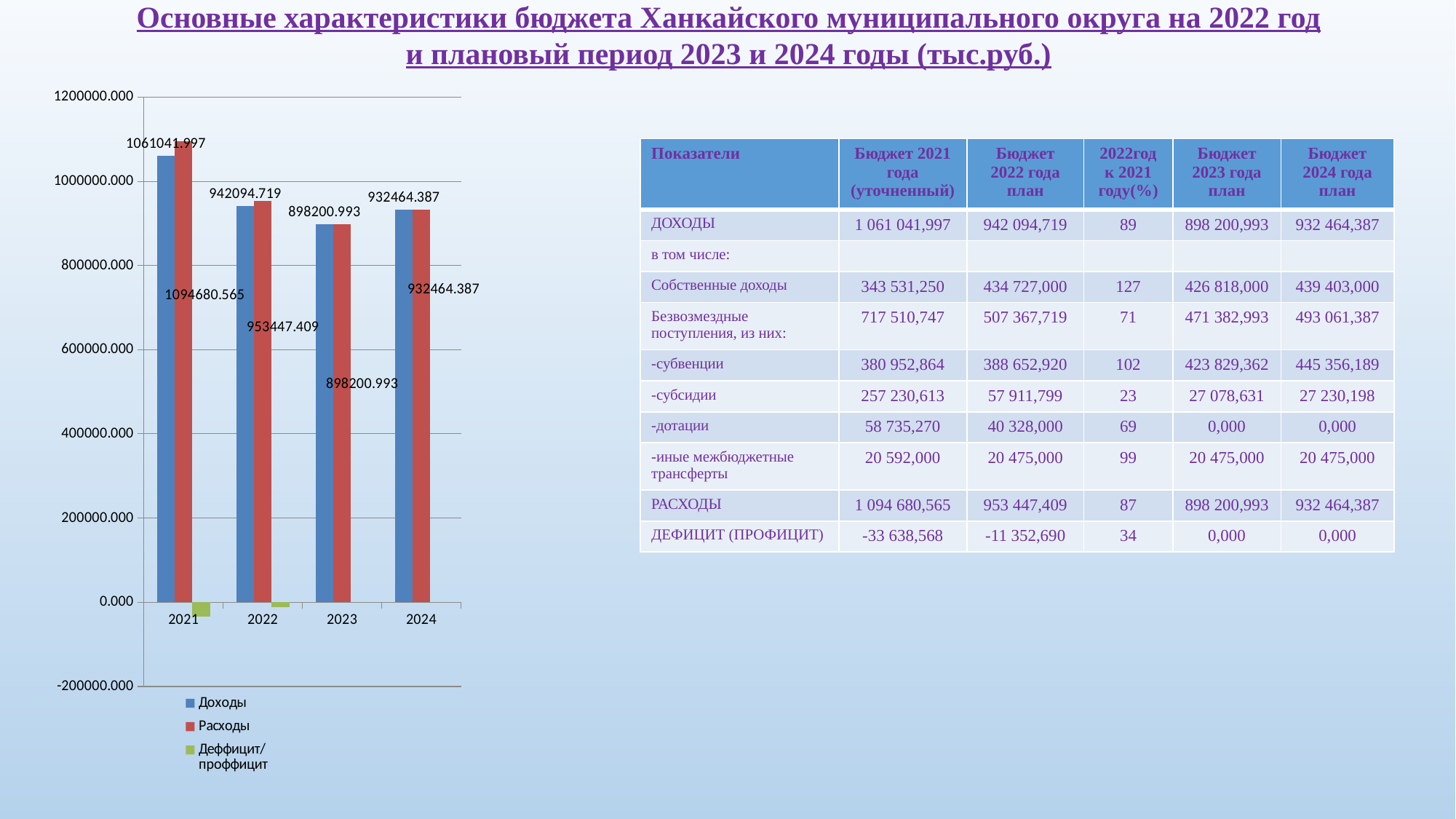
How many years are shown on the x axis of the chart? 4 What is the difference between Расходы and Доходы for 2021 in the chart? 33638.568 What is the value of Расходы for 2024 in the chart? 932464.387 What type of chart is shown on the slide? bar chart What is the value of Расходы for 2022 in the chart? 953447.409 What is the value of Доходы for 2023 in the chart? 898200.993 What is the value of Доходы for 2021 in the chart? 1061041.997 In which year is Доходы highest in the chart? 2021 Which is larger in 2022 in the chart, Доходы or Расходы? Расходы How many series does the chart legend list? 3 In which year is Расходы lowest in the chart? 2023 Is the Деффицит/проффицит value for 2021 greater or less than 0.000? less